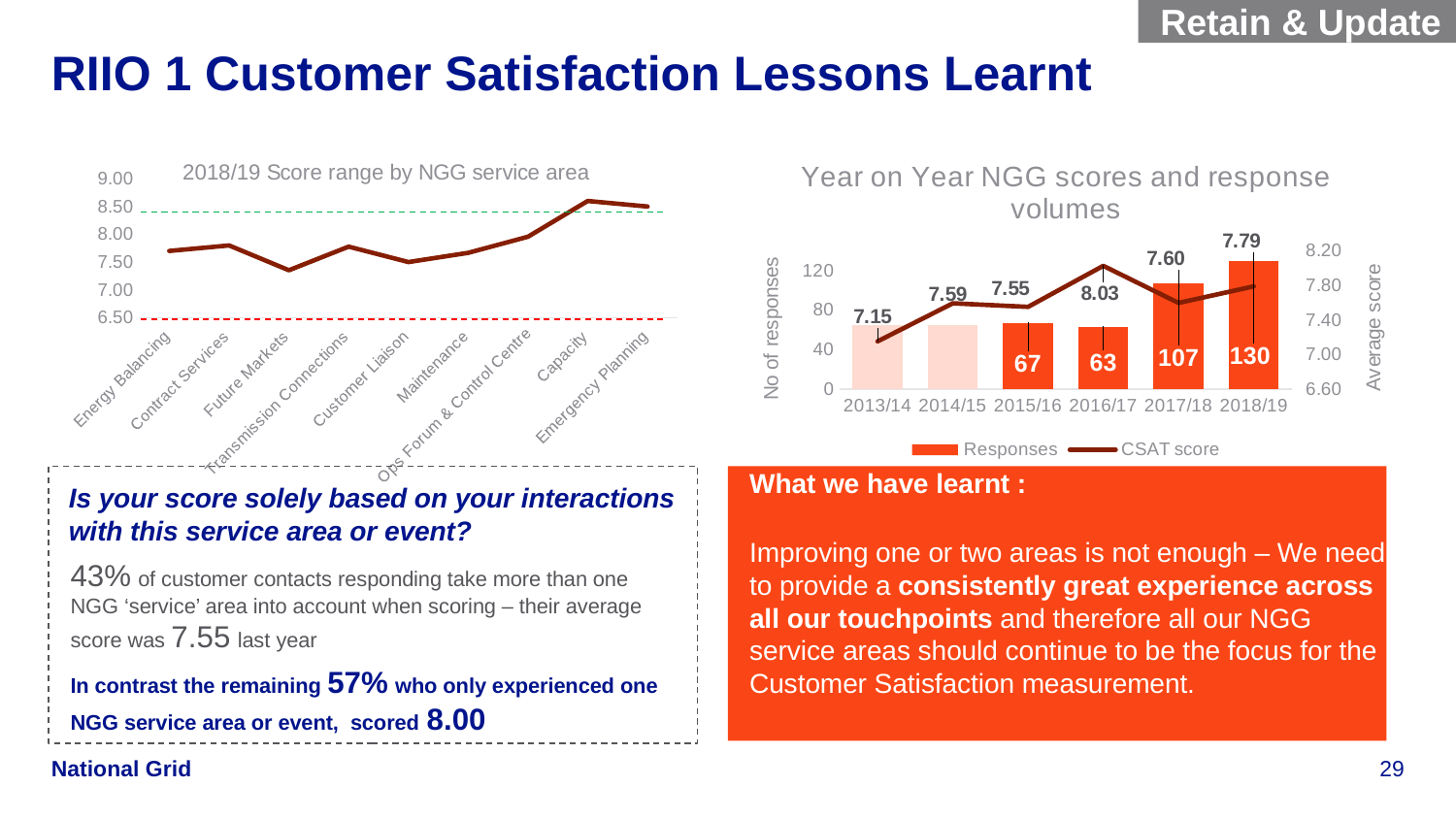
How many service areas are shown on the x axis of the '2018/19 Score range by NGG service area' chart? 9 In the 'Year on Year NGG scores and response volumes' chart, which year had more responses, 2015/16 or 2016/17? 2015/16 In the 'Year on Year NGG scores and response volumes' chart, how many responses were recorded in 2018/19? 130 In the 'Year on Year NGG scores and response volumes' chart, which year has the highest CSAT score? 2016/17 How many years are shown on the x axis of the 'Year on Year NGG scores and response volumes' chart? 6 What kind of chart is the '2018/19 Score range by NGG service area' chart? Line chart In the 'Year on Year NGG scores and response volumes' chart, what is the CSAT score for 2013/14? 7.15 How many series does the legend of the 'Year on Year NGG scores and response volumes' chart list? 2 In the 'Year on Year NGG scores and response volumes' chart, how many more responses were there in 2018/19 than in 2017/18? 23 In the 'Year on Year NGG scores and response volumes' chart, which year has the lowest CSAT score? 2013/14 In the '2018/19 Score range by NGG service area' chart, which service area has the highest score? Capacity In the '2018/19 Score range by NGG service area' chart, is the value for Future Markets greater or less than 7.50? less